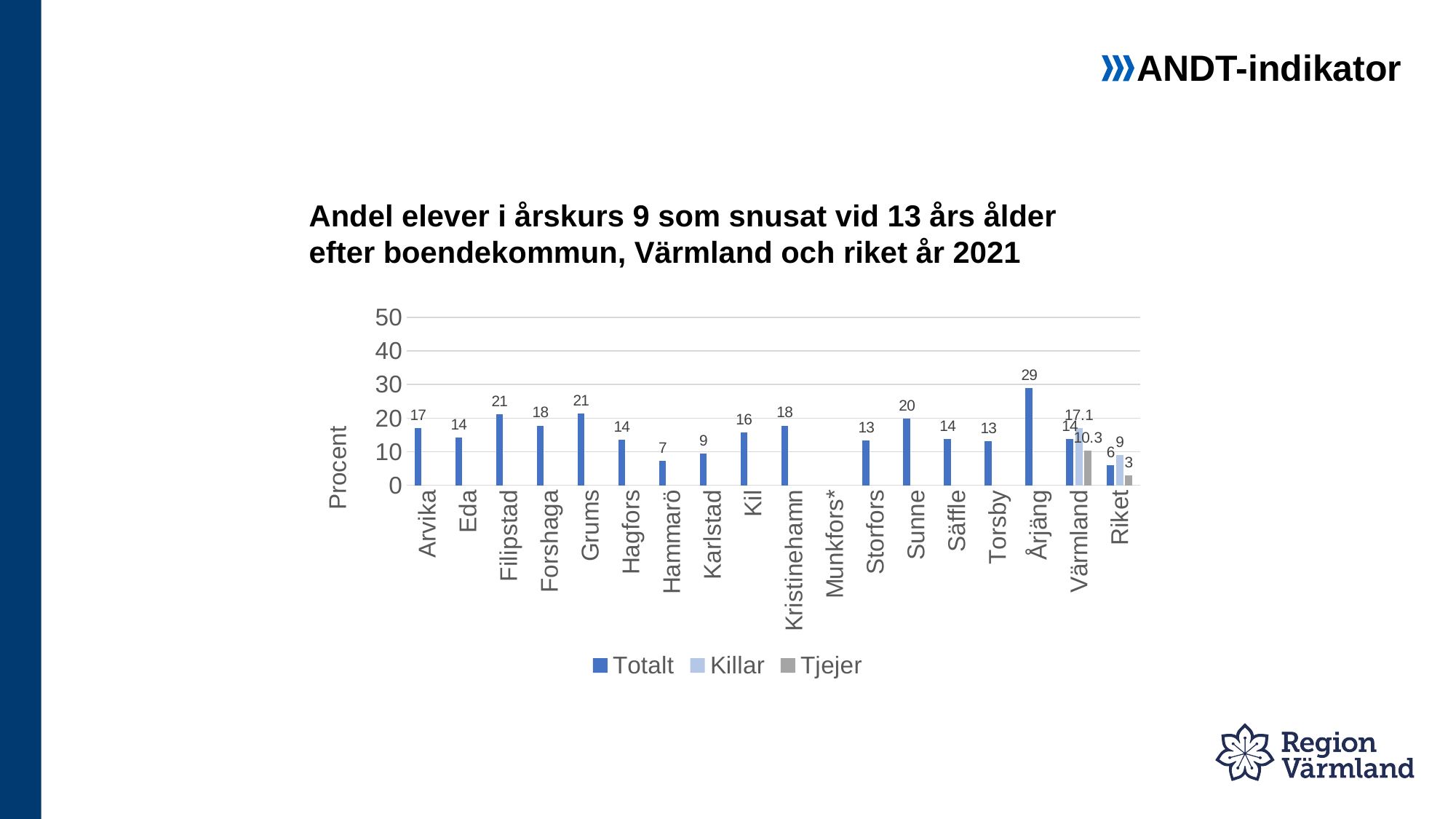
Which has a higher Totalt value, Sunne or Kristinehamn? Sunne What kind of chart is shown on the slide? bar chart What is the difference between the Totalt values for Filipstad and Hammarö? 14 Among the municipalities (excluding Värmland and Riket), which has the lowest Totalt value? Hammarö What is the Totalt value for Årjäng? 29 What is the label on the y axis? Procent Which category has the highest Totalt value? Årjäng How many categories are shown on the x axis? 18 How many series does the legend list? 3 What is the Tjejer value for Riket? 3 Is the Totalt value for Karlstad greater or less than 10? less What is the Killar value for Värmland? 17.1